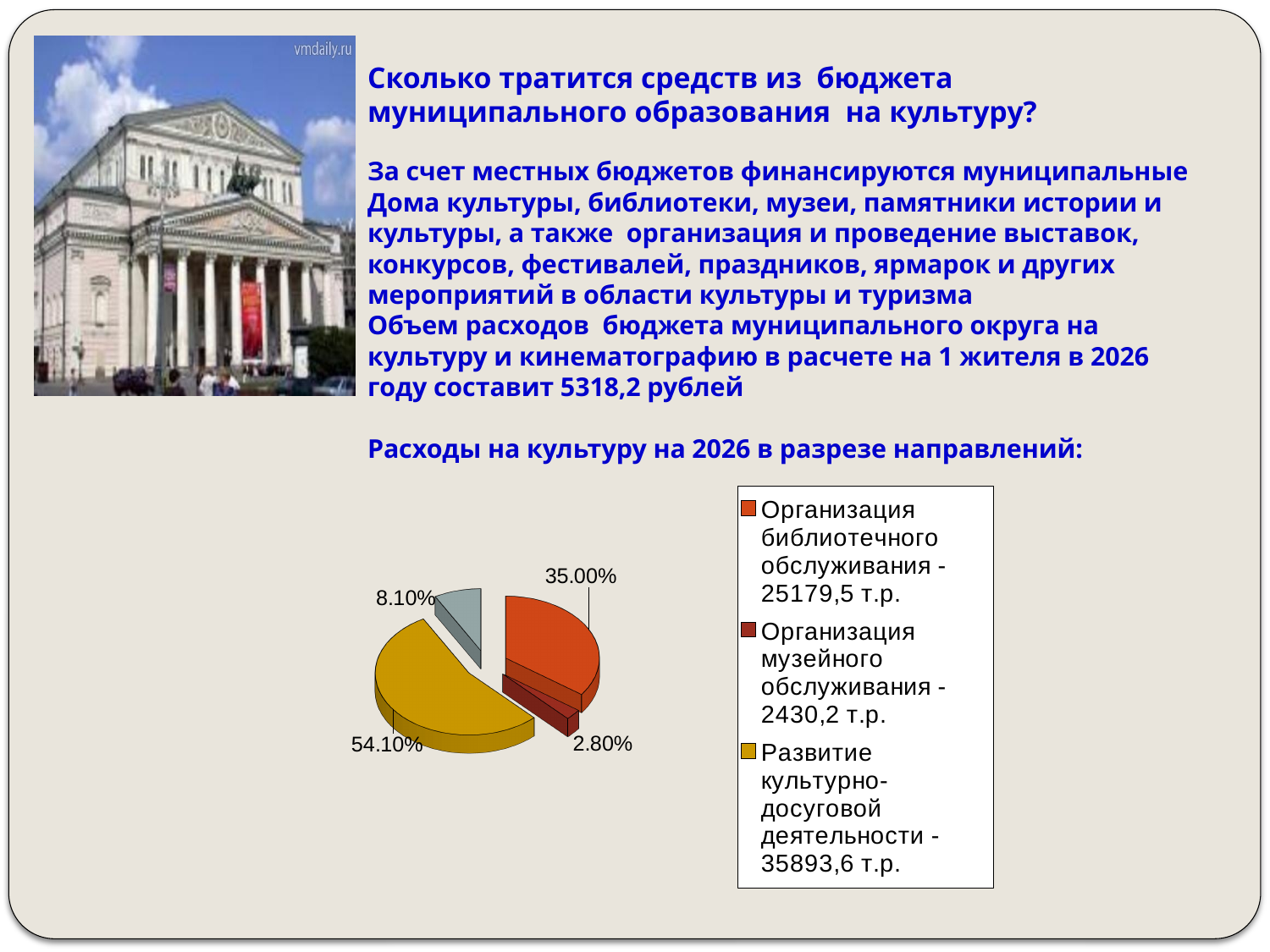
What amount in thousand rubles does the legend give for 'Организация музейного обслуживания'? 2430,2 т.р. What kind of chart is shown on the slide? pie chart What colour is the slice for 'Развитие культурно-досуговой деятельности'? yellow What share of the pie does 'Развитие культурно-досуговой деятельности' take? 54.10% Which slice is larger: 'Организация библиотечного обслуживания' or 'Организация музейного обслуживания'? Организация библиотечного обслуживания Which legend category has the largest slice of the pie? Развитие культурно-досуговой деятельности What share of the pie does 'Организация музейного обслуживания' take? 2.80% How many slices does the pie chart have? 4 What is the difference in percentage points between the 'Развитие культурно-досуговой деятельности' slice and the 'Организация библиотечного обслуживания' slice? 19.10% Which legend category has the smallest slice of the pie? Организация музейного обслуживания How many entries does the legend list? 3 What share of the pie does 'Организация библиотечного обслуживания' take? 35.00%